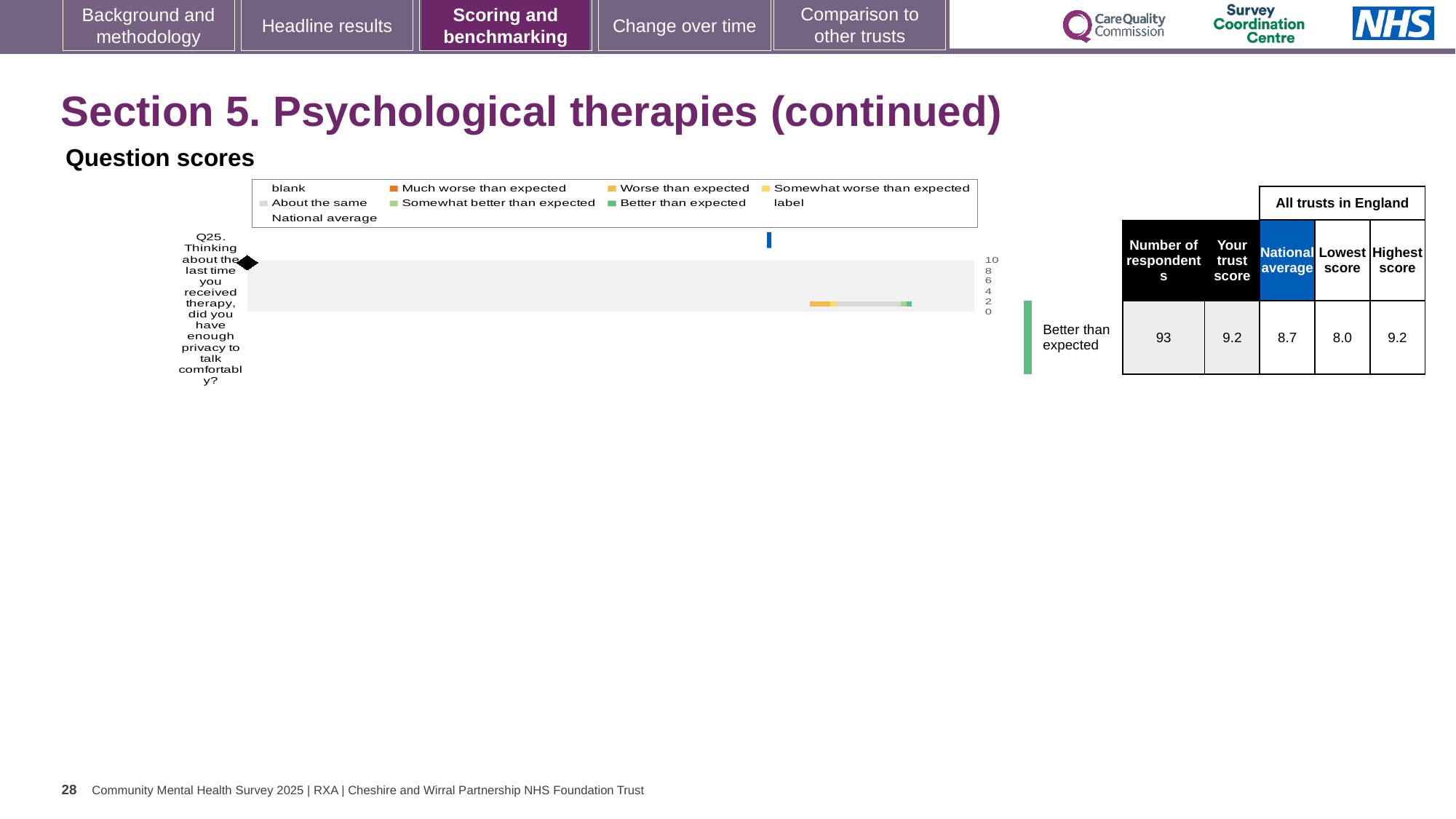
Which is larger for Q25: the trust's score or the national average? Your trust score How many survey questions are plotted in the Question scores chart? 1 What is the trust's score for Q25 shown alongside the chart? 9.2 What is the lowest score among all trusts in England for Q25? 8.0 Which question is plotted in the Question scores chart? Q25 What colour represents 'Better than expected' in the chart legend? Green What is the maximum value shown on the chart's score axis? 10 By how much does the trust's score for Q25 exceed the national average? 0.5 What is the highest score among all trusts in England for Q25? 9.2 What benchmarking category is Q25 rated as on this slide? Better than expected What is the national average score for Q25? 8.7 How many respondents answered Q25? 93